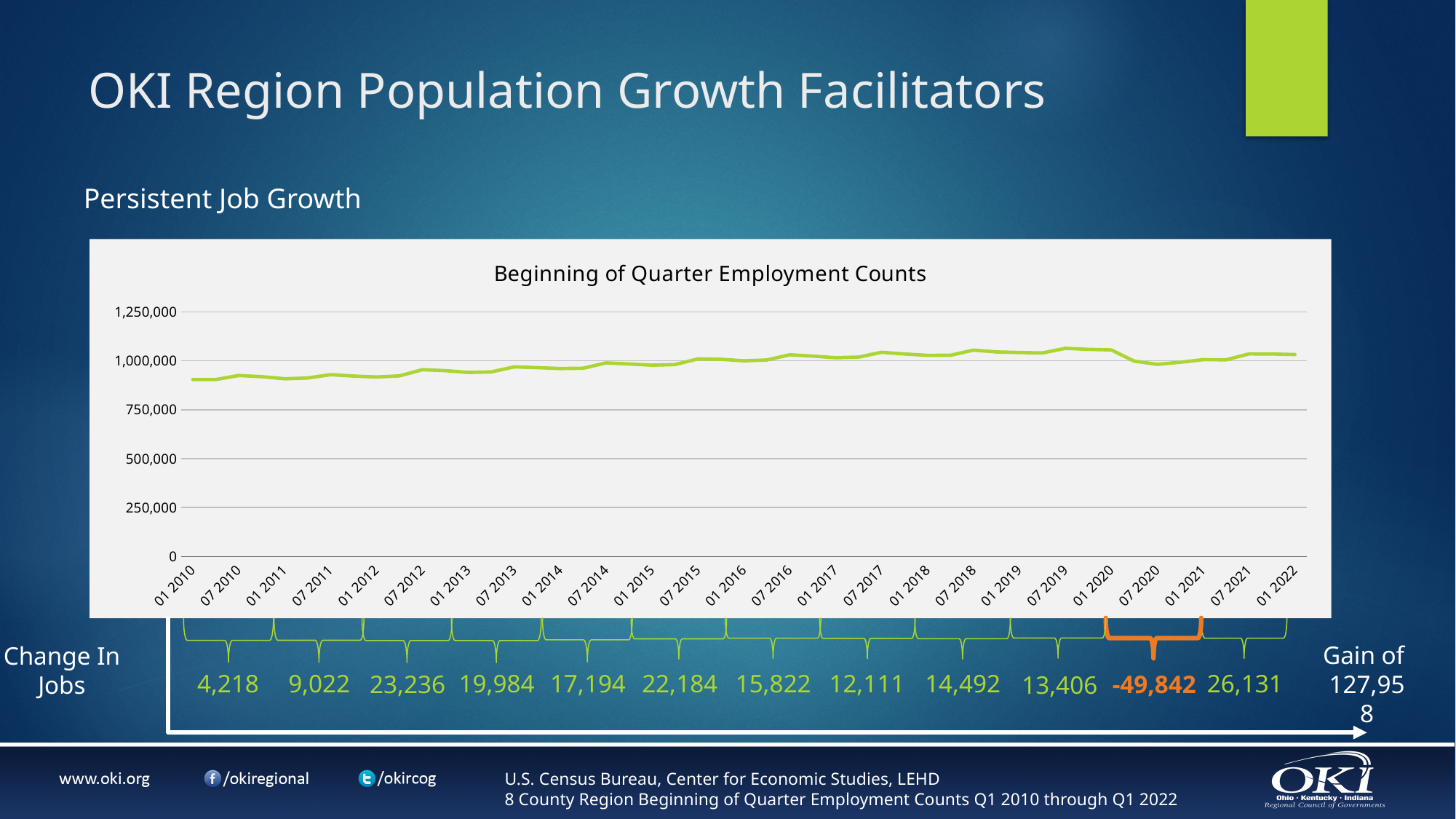
What kind of chart is shown on the slide? line chart Is the employment count for 01 2020 greater or less than 1,000,000? greater Which 'Change In Jobs' value below the chart is highlighted in orange? -49,842 Is the employment count for 01 2010 greater or less than 1,000,000? less What is the largest 'Change In Jobs' value printed below the chart? 26,131 What is the highest value shown on the vertical axis of the chart? 1,250,000 Is the employment count for 01 2010 greater or less than 750,000? greater What is the title of the chart? Beginning of Quarter Employment Counts Does the employment count generally rise or fall from 01 2010 to 01 2020? rise What total gain in jobs is stated at the right of the 'Change In Jobs' row? 127,958 How many date labels are shown along the x axis of the chart? 25